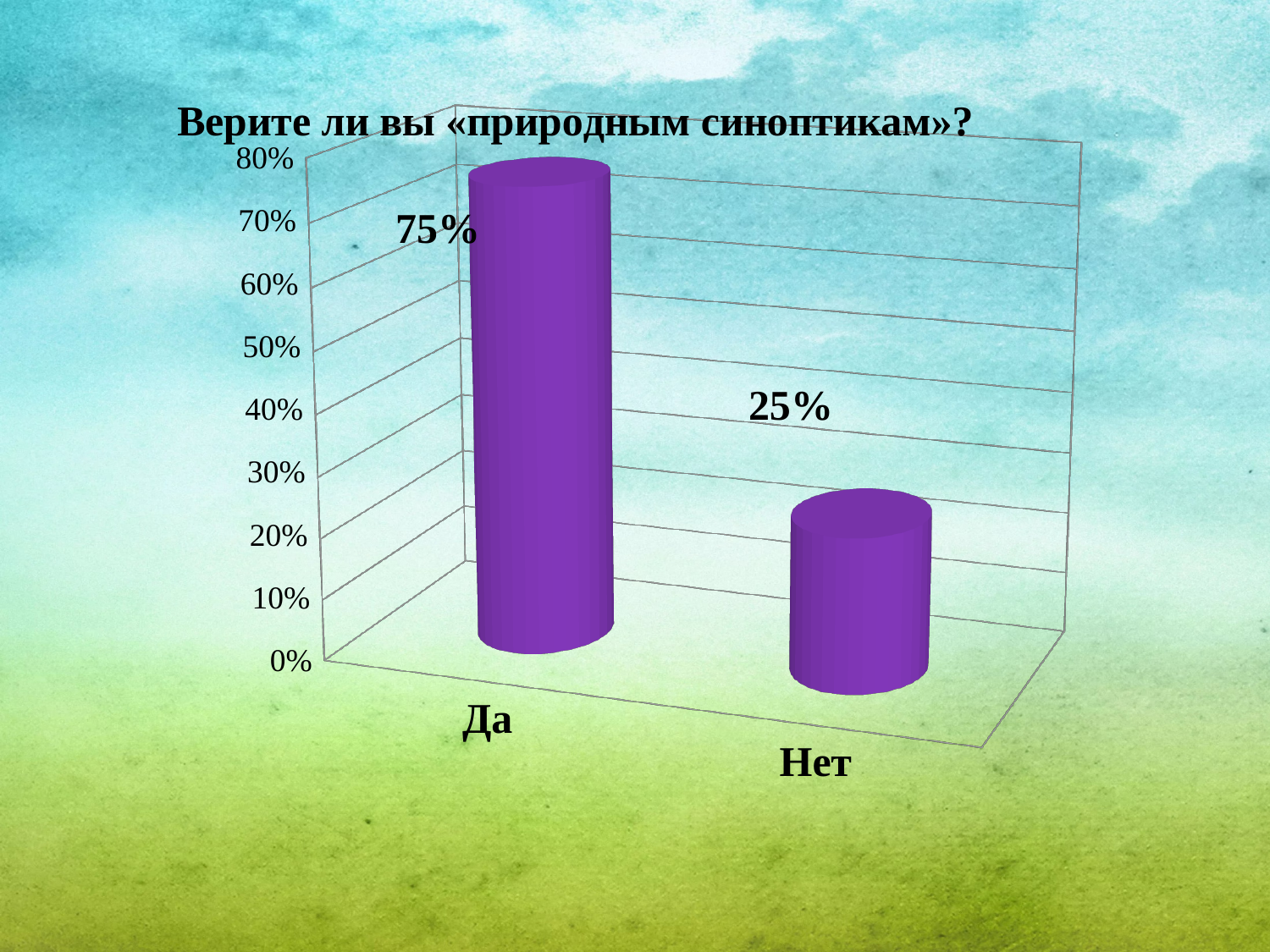
What is the value for «Да»? 75% Is the value for «Нет» greater or less than 30%? less How many categories are shown on the chart? 2 What colour are the bars on the chart? purple What is the value for «Нет»? 25% Which is larger, the value for «Да» or the value for «Нет»? Да What is the title of the chart? Верите ли вы «природным синоптикам»? What is the difference between the values for «Да» and «Нет»? 50% Is the value for «Да» greater or less than 70%? greater Which category has the highest value? Да Which category has the lowest value? Нет What kind of chart is shown on the slide? bar chart